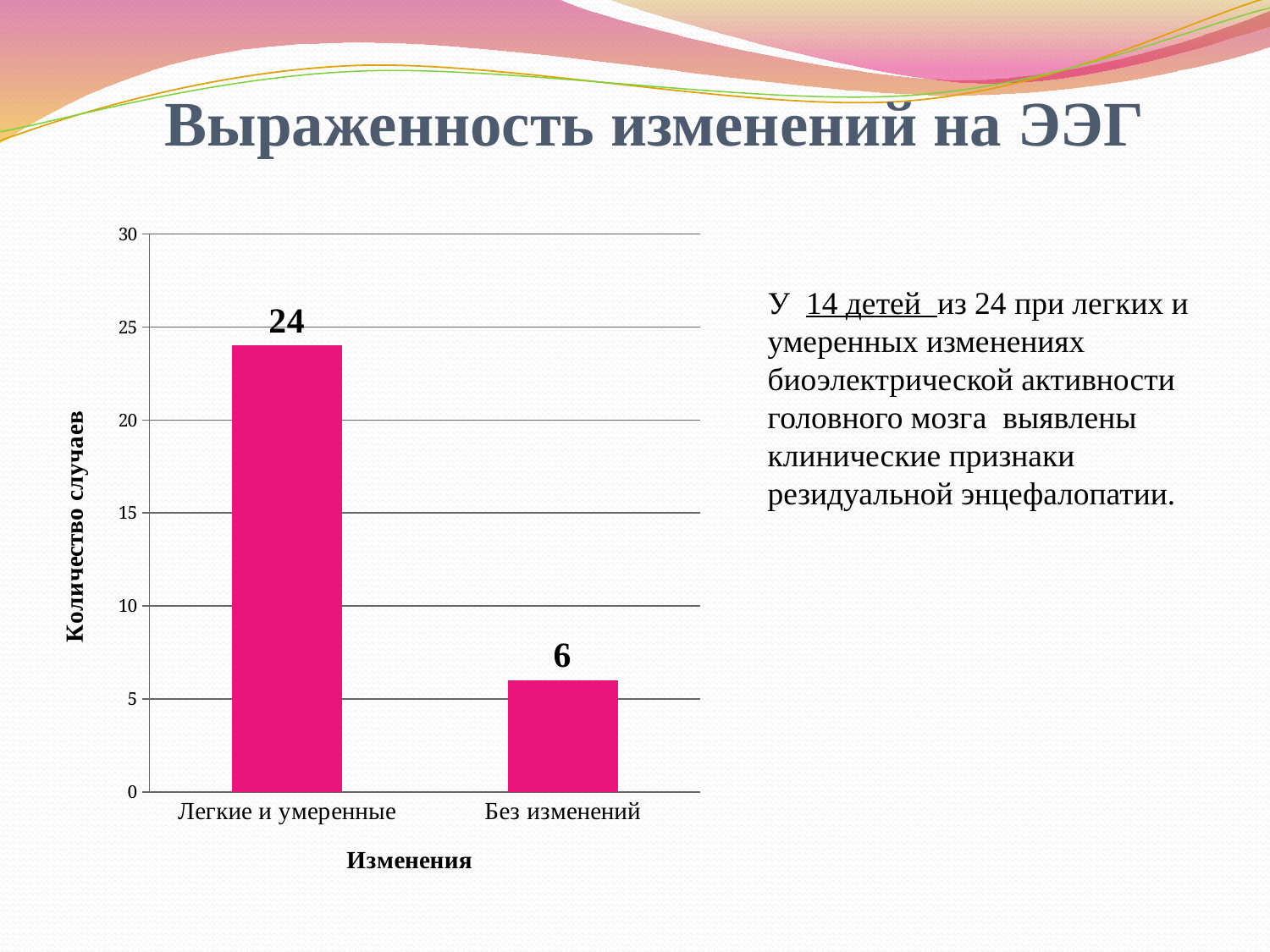
Is the value for "Легкие и умеренные" greater or less than 20? greater Is the value for "Без изменений" greater or less than 10? less What is the label of the vertical axis? Количество случаев What is the title of the slide's chart? Выраженность изменений на ЭЭГ Which category has the highest value? Легкие и умеренные What is the difference between the values for "Легкие и умеренные" and "Без изменений"? 18 What is the value for "Без изменений"? 6 What kind of chart is shown on the slide? bar chart How many categories are shown on the x axis? 2 What is the value for "Легкие и умеренные"? 24 Which category has the lowest value? Без изменений Which is larger, the value for "Легкие и умеренные" or for "Без изменений"? Легкие и умеренные